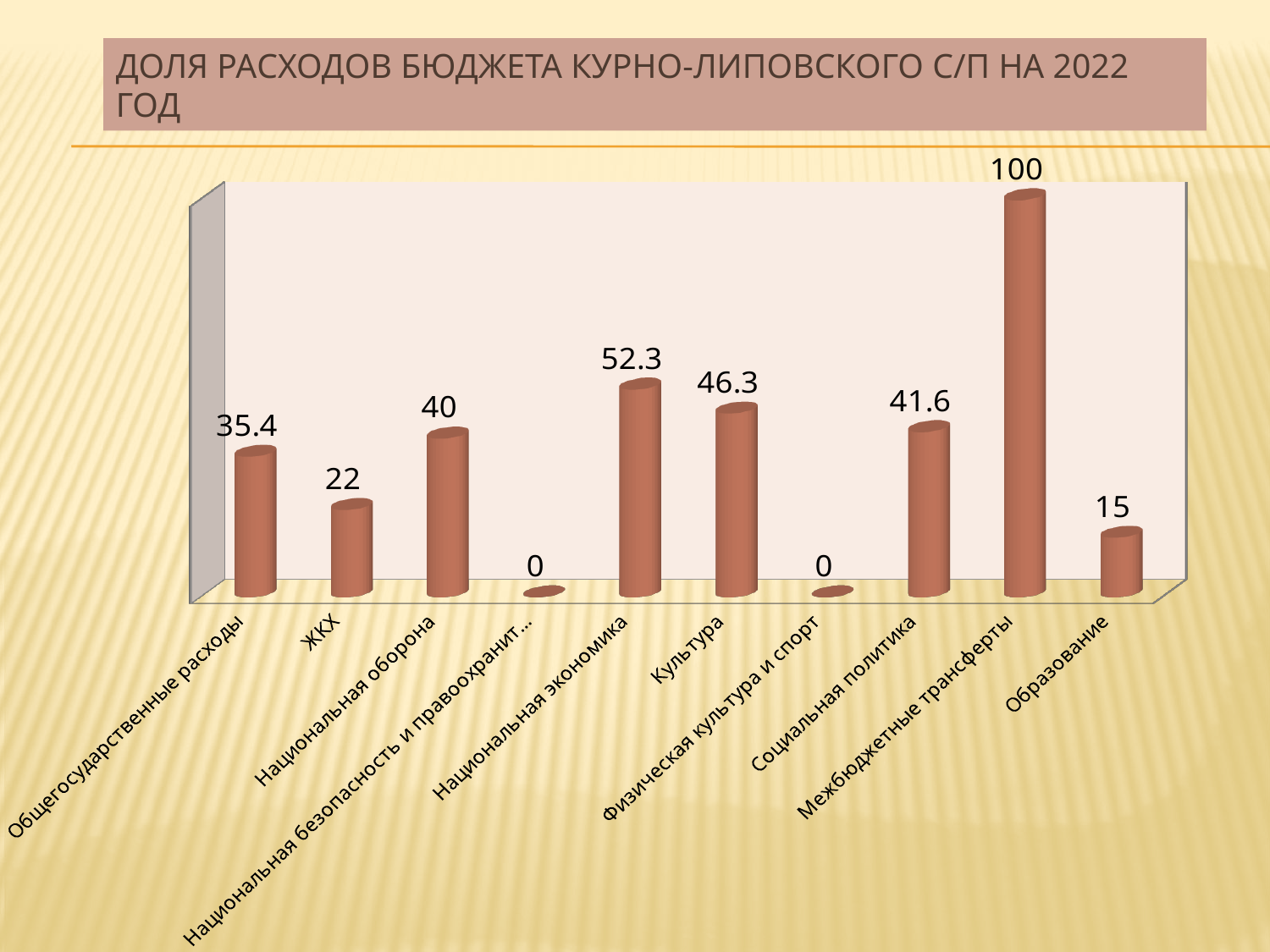
Which category has the highest value? Межбюджетные трансферты Which is larger, the value for Культура or the value for Социальная политика? Культура How many categories are shown on the chart? 10 What kind of chart is shown on the slide? Bar chart How many categories have a value of 0? 2 What is the difference between the values for Национальная оборона and Общегосударственные расходы? 4.6 What is the title of the chart on the slide? ДОЛЯ РАСХОДОВ БЮДЖЕТА КУРНО-ЛИПОВСКОГО С/П НА 2022 ГОД What is the value for Социальная политика? 41.6 What is the value for ЖКХ? 22 What is the value for Национальная экономика? 52.3 What is the difference between the values for Межбюджетные трансферты and Культура? 53.7 What is the value for Образование? 15